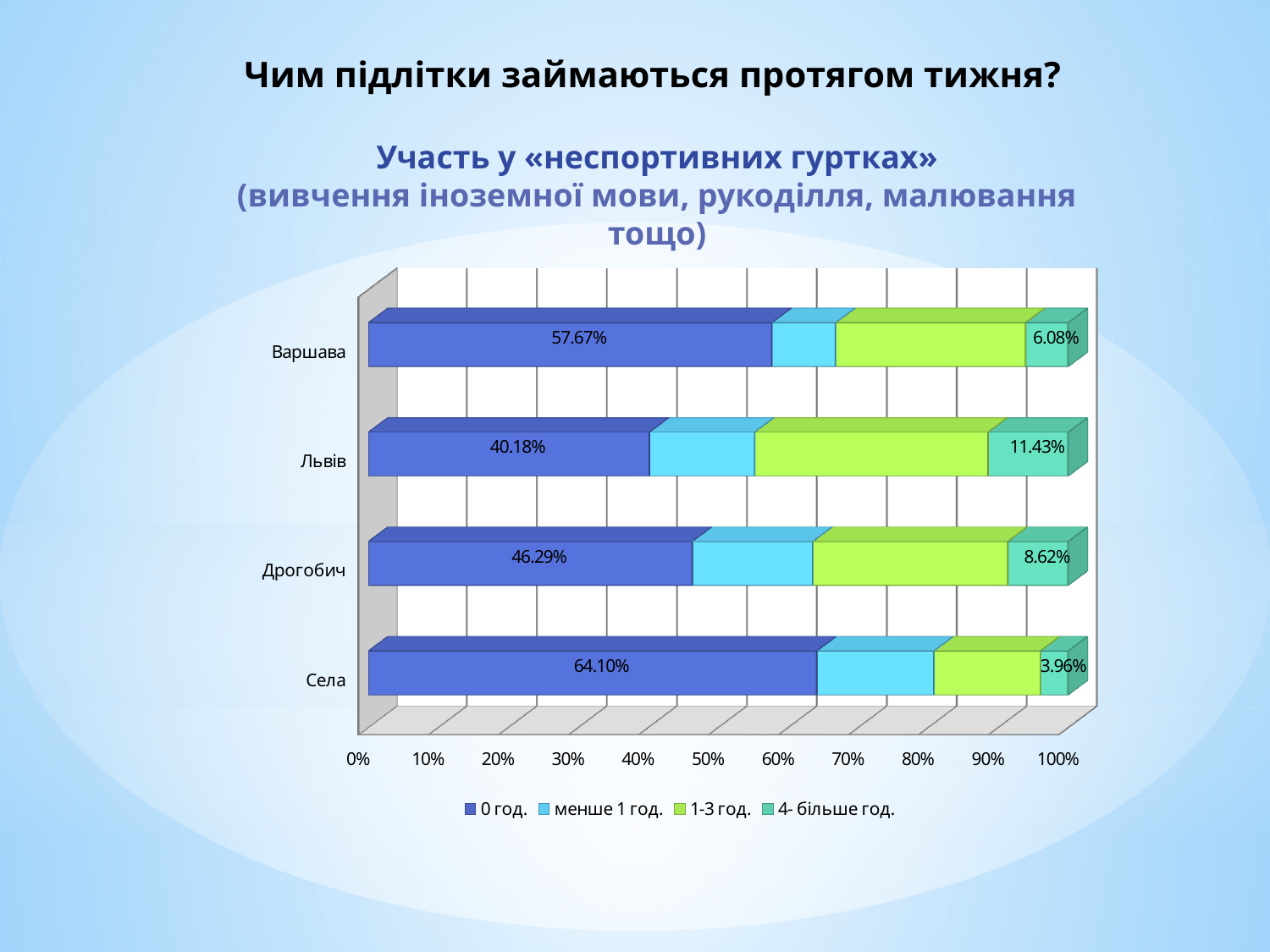
Which is larger: the "4- більше год." value for Львів or for Варшава? Львів Which category has the highest value for the "0 год." series? Села What is the value of the "0 год." series for Львів? 40.18% What is the value of the "4- більше год." series for Дрогобич? 8.62% Which category has the lowest value for the "4- більше год." series? Села What is the value of the "0 год." series for Варшава? 57.67% What is the value of the "4- більше год." series for Села? 3.96% How many series does the legend list? 4 What type of chart is shown on the slide? stacked bar chart Is the "0 год." value for Дрогобич greater or less than 50%? less How many categories are shown on the chart? 4 What is the difference between the "0 год." values for Села and Львів? 23.92%